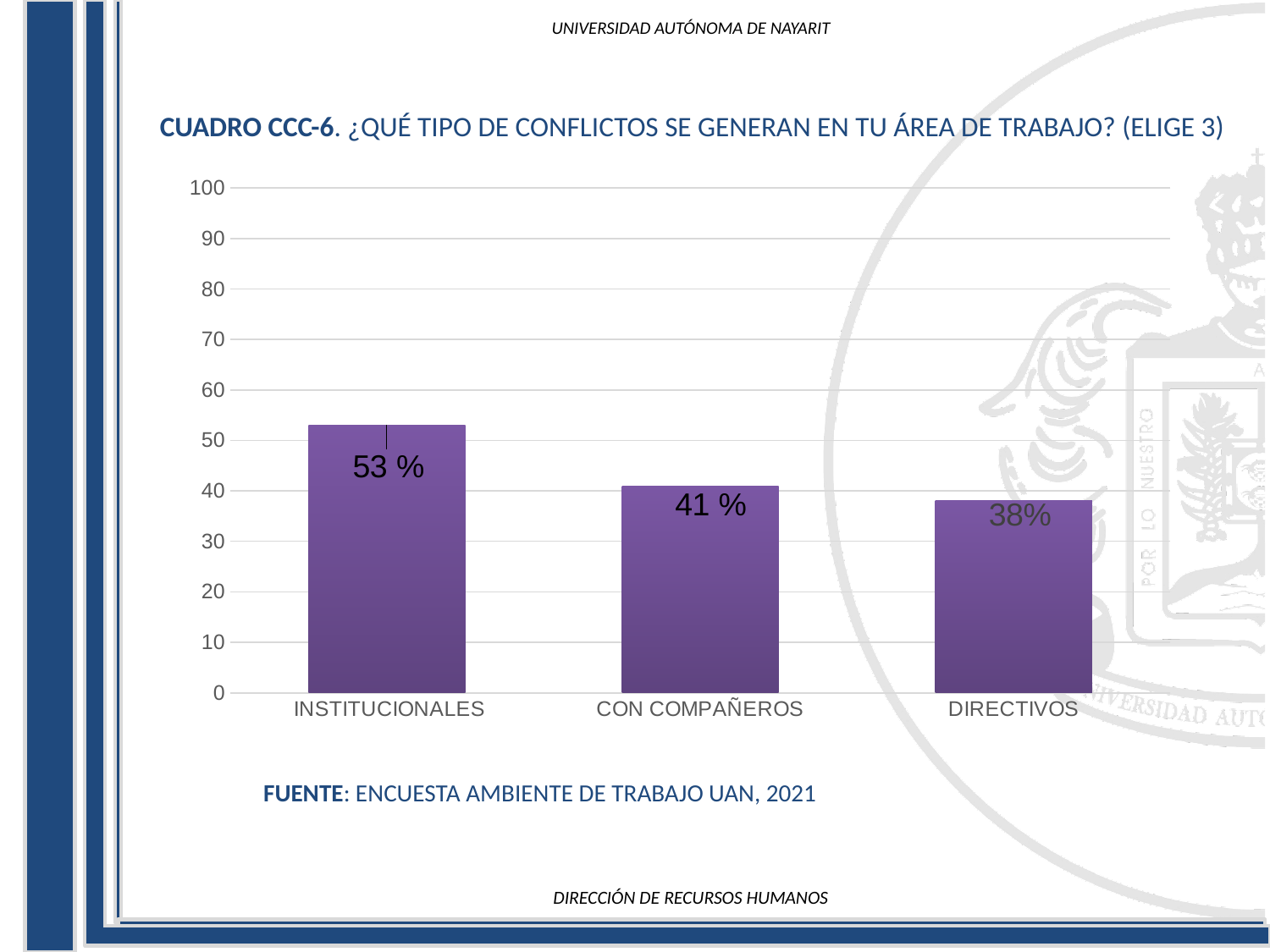
Do the values rise or fall from left to right along the x axis? fall Which is larger, the value for CON COMPAÑEROS or the value for DIRECTIVOS? CON COMPAÑEROS What is the difference between the values for INSTITUCIONALES and CON COMPAÑEROS? 12 How many categories are shown on the x axis? 3 What is the value for CON COMPAÑEROS? 41 % What is the value for DIRECTIVOS? 38% What is the difference between the values for INSTITUCIONALES and DIRECTIVOS? 15 Which category has the highest value? INSTITUCIONALES Which category has the lowest value? DIRECTIVOS What is the value for INSTITUCIONALES? 53 % What kind of chart is shown on the slide? bar chart Is the value for INSTITUCIONALES greater or less than 50? greater